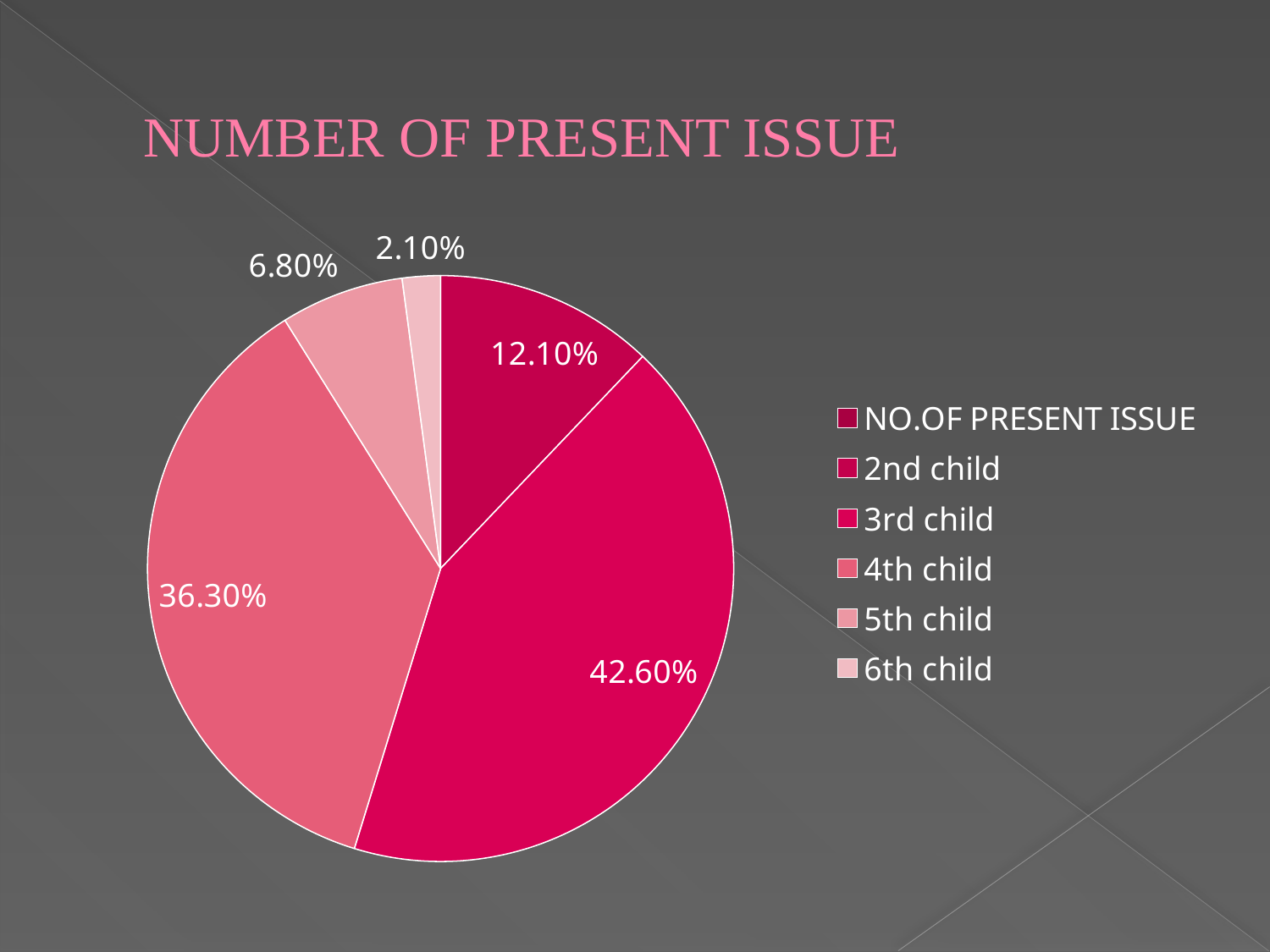
How many entries does the legend list? 6 What percentage is shown for 2nd child? 12.10% What is the smallest percentage labelled on the pie? 2.10% What is the difference between the 2nd child and 3rd child percentages? 30.50% What percentage is shown for 4th child? 36.30% Which category has the largest slice of the pie? 3rd child Which is larger, the 3rd child slice or the 4th child slice? 3rd child What type of chart is shown on the slide? pie chart What is the combined percentage of the 2nd child and 3rd child slices? 54.70% What is the title of the chart? NUMBER OF PRESENT ISSUE What percentage is shown for 3rd child? 42.60%